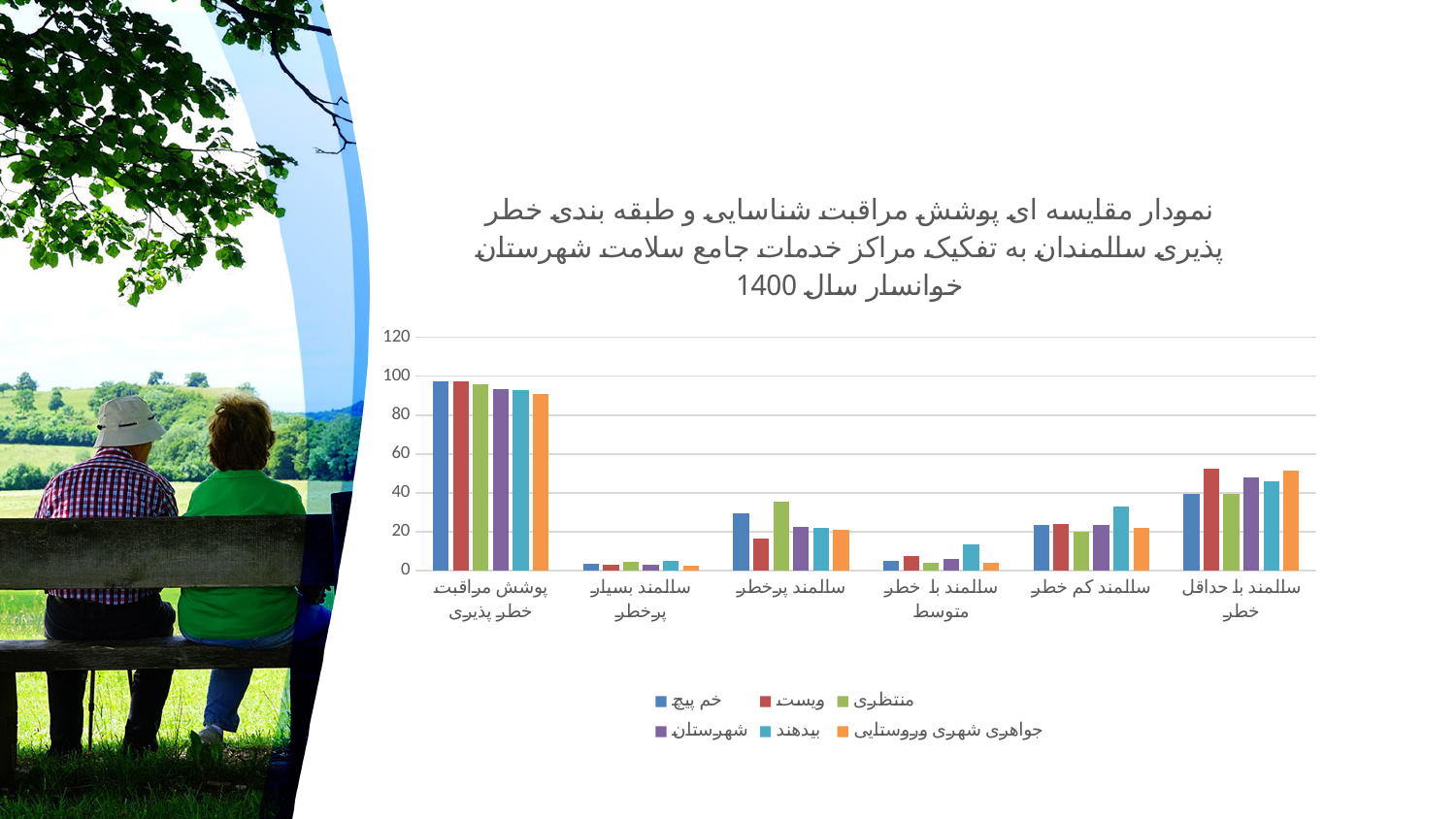
Which series has the highest value in the سالمند پرخطر category? منتظری In the سالمند با خطر متوسط category, which is larger: the value for بیدهند or the value for خم پیچ? بیدهند How many categories are shown on the x axis of the chart? 6 What kind of chart is shown on the slide? bar chart In the سالمند پرخطر category, which is larger: the value for منتظری or the value for ویست? منتظری Is the value for ویست in the سالمند با حداقل خطر category greater or less than 40? greater What colour are the bars for the خم پیچ series? blue Is the value for ویست in the سالمند بسیار پرخطر category greater or less than 20? less Is the value for منتظری in the سالمند پرخطر category greater or less than 20? greater How many series does the legend list? 6 Which category has the lowest values across all series? سالمند بسیار پرخطر